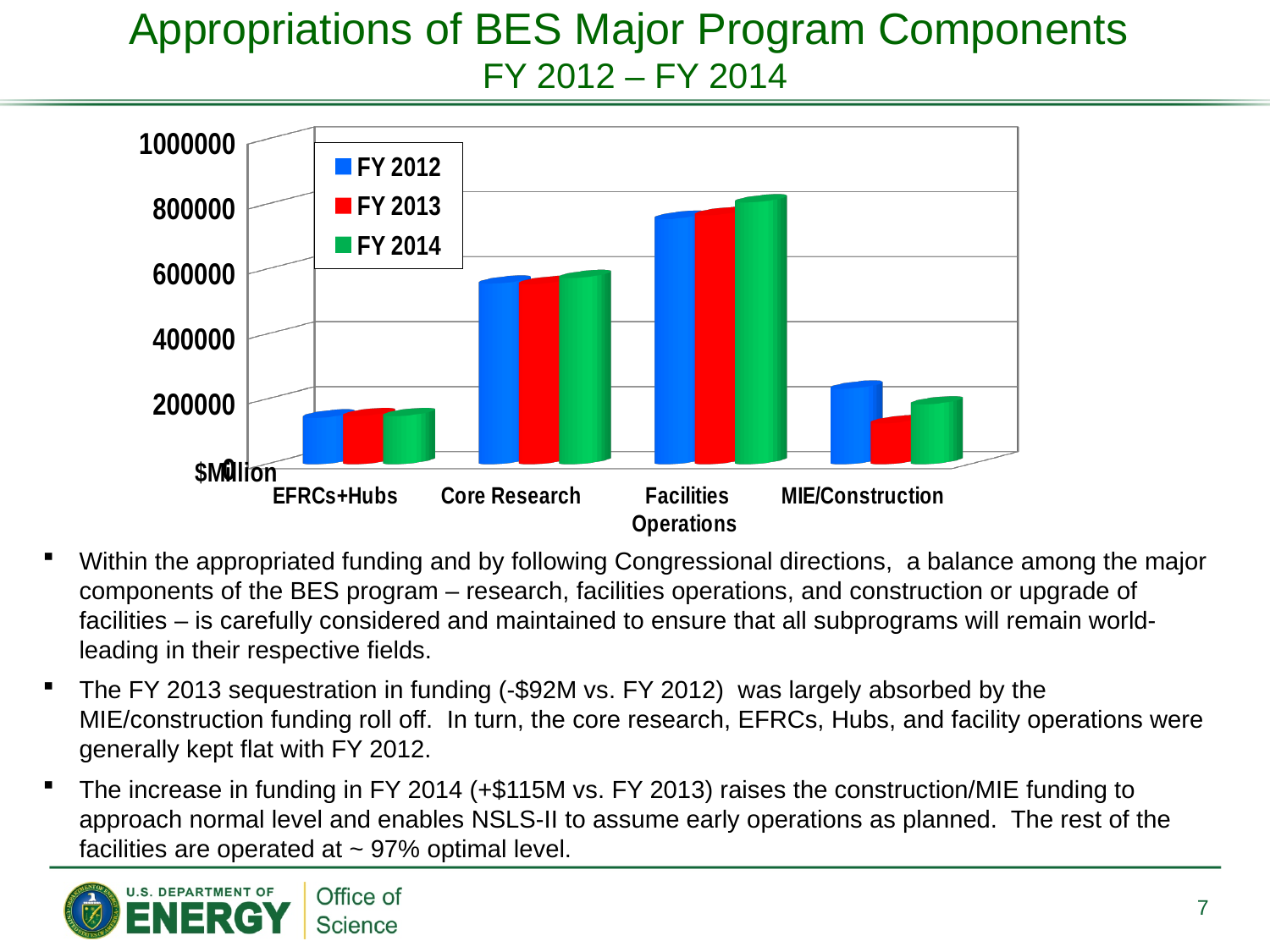
Which category has the lowest FY 2012 value? EFRCs+Hubs Is the FY 2013 value for MIE/Construction greater or less than 200000? less For MIE/Construction, which is larger: the FY 2012 value or the FY 2013 value? FY 2012 How many categories are shown on the x axis of the chart? 4 What kind of chart is shown on the slide? bar chart Is the FY 2013 value for EFRCs+Hubs greater or less than 200000? less Is the FY 2014 value for Core Research greater or less than 400000? greater How many series does the chart's legend list? 3 Which category has the highest FY 2012 value? Facilities Operations What is the title of the chart on the slide? Appropriations of BES Major Program Components FY 2012 – FY 2014 Which colour represents FY 2014 in the chart's legend? green